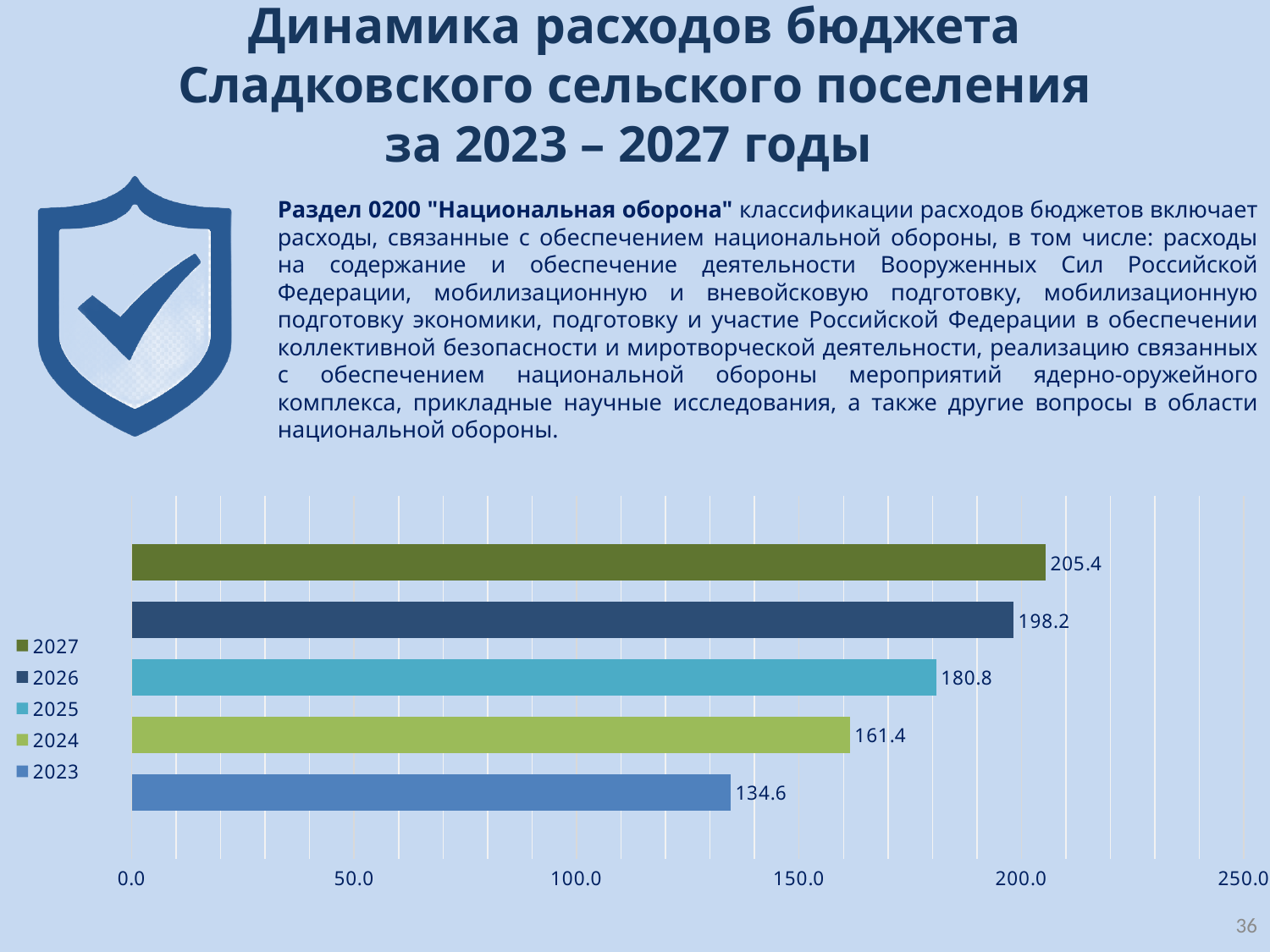
What is the difference between the values for 2027 and 2023? 70.8 Is the value for 2026 greater or less than 150.0? greater How many bars are shown in the chart? 5 What is the value for 2025? 180.8 What is the value for 2023? 134.6 How many entries does the legend list? 5 Which is larger, the value for 2024 or the value for 2025? 2025 Which year has the lowest value? 2023 What kind of chart is shown on the slide? bar chart What is the value for 2027? 205.4 Which year has the highest value? 2027 What is the difference between the values for 2026 and 2024? 36.8